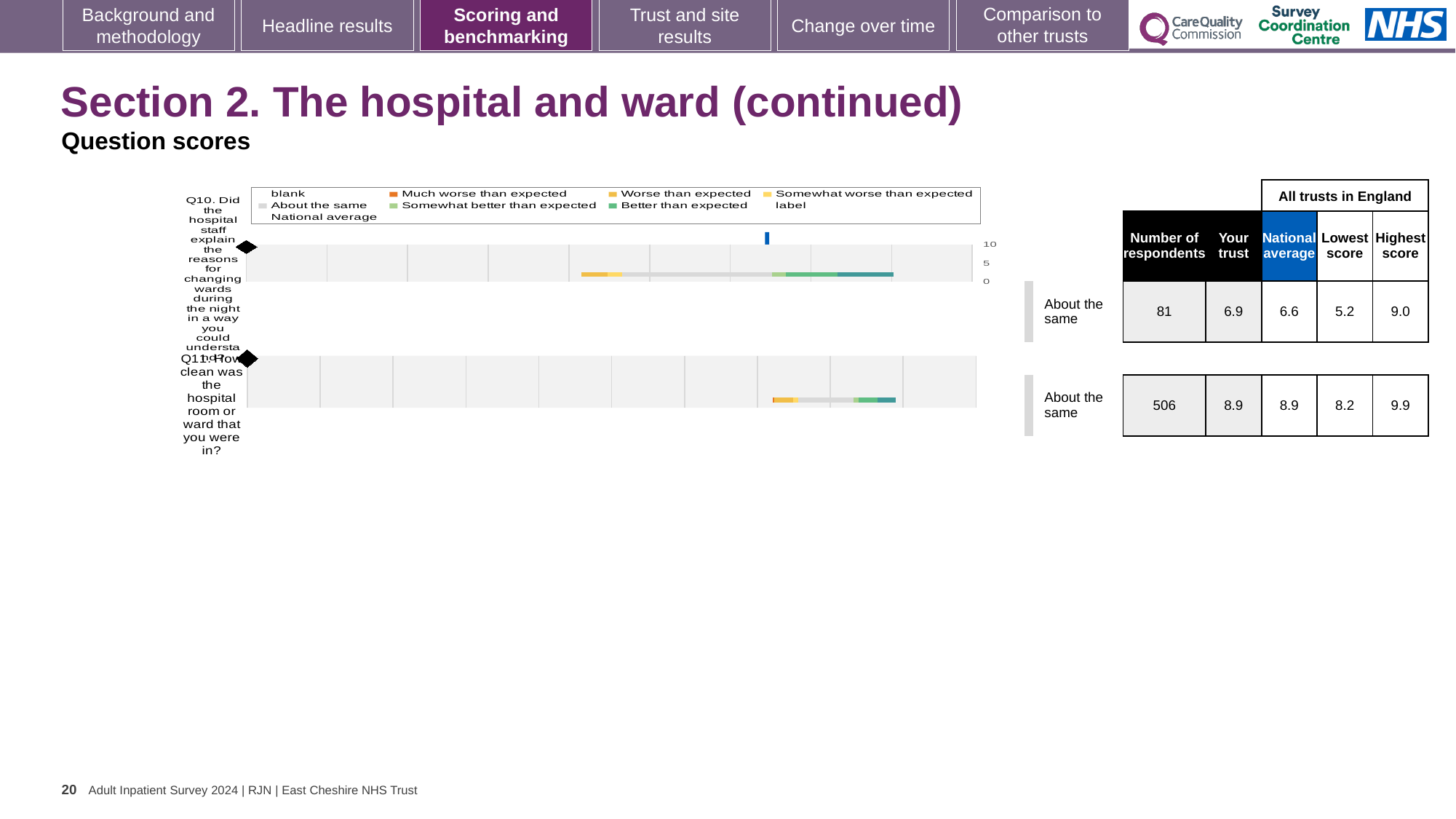
What is the national average score for Q10? 6.6 What is the difference between the highest and lowest scores for Q11? 1.7 What benchmark category is shown for Q10 next to its bar chart? About the same Which question had more respondents, Q10 or Q11? Q11 What is the lowest score among all trusts in England for Q11? 8.2 How many questions (Q10 and Q11) have a bar chart on this slide? 2 What is the 'Your trust' score for Q10 (explaining reasons for changing wards during the night)? 6.9 How many respondents answered Q11 (how clean was the hospital room or ward)? 506 What is the highest score among all trusts in England for Q11? 9.9 What kind of chart is used to show the Q10 and Q11 question scores? bar chart For Q10, which is higher: the 'Your trust' score or the national average? Your trust What is the difference between the highest and lowest scores for Q10? 3.8